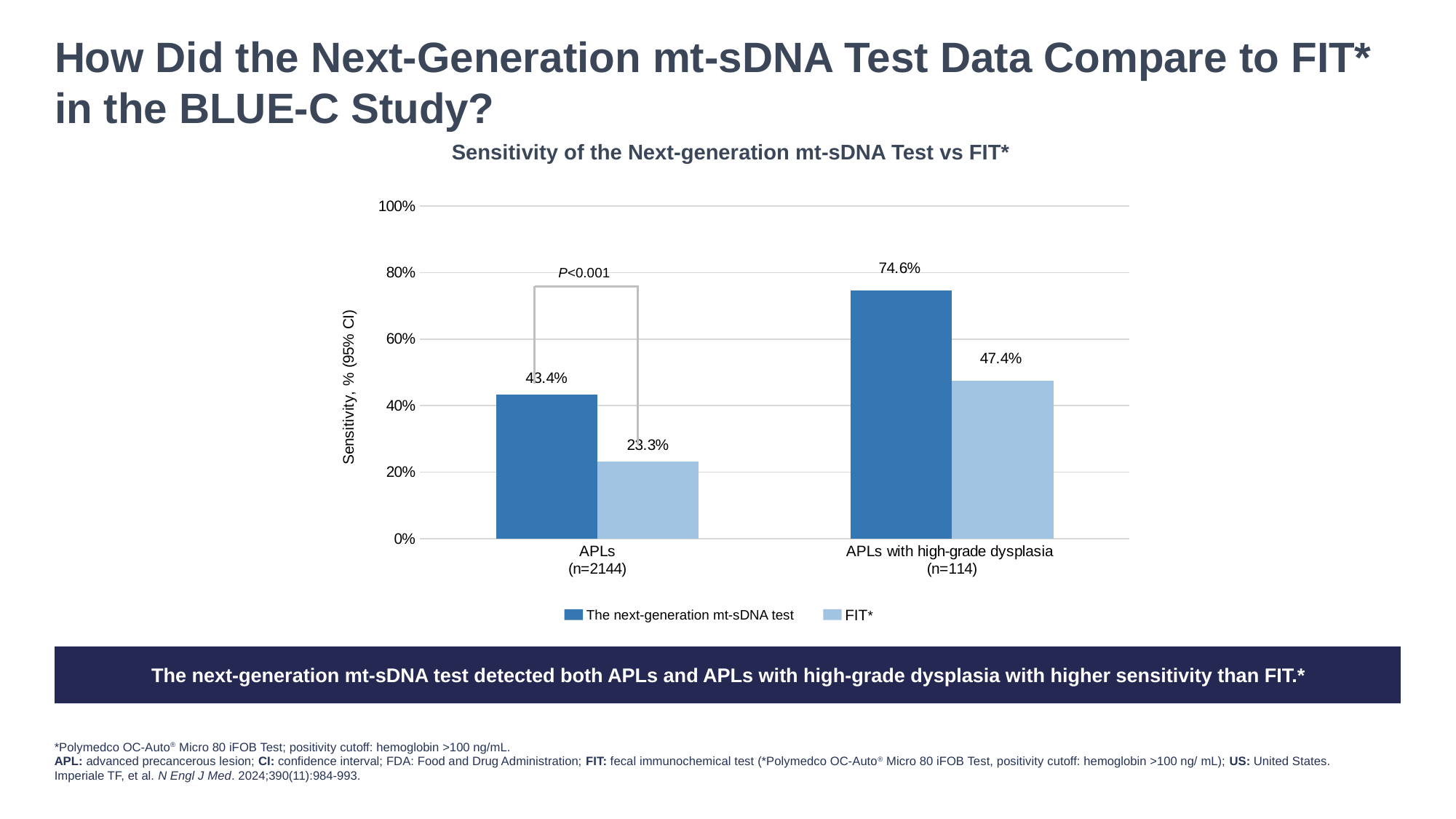
How many categories are shown on the x axis? 2 What is the difference in sensitivity between the next-generation mt-sDNA test and FIT* for APLs? 20.1% What is the sensitivity of the next-generation mt-sDNA test for APLs? 43.4% How many series does the legend list? 2 Which bar shows the lowest sensitivity on the chart? FIT* for APLs What P value is shown above the APLs bars? P<0.001 What is the sensitivity of FIT* for APLs? 23.3% For APLs with high-grade dysplasia, which test has the higher sensitivity? The next-generation mt-sDNA test What is the difference in sensitivity between the next-generation mt-sDNA test and FIT* for APLs with high-grade dysplasia? 27.2% Which bar shows the highest sensitivity on the chart? The next-generation mt-sDNA test for APLs with high-grade dysplasia What kind of chart is shown on the slide? Bar chart What is the sensitivity of FIT* for APLs with high-grade dysplasia? 47.4%